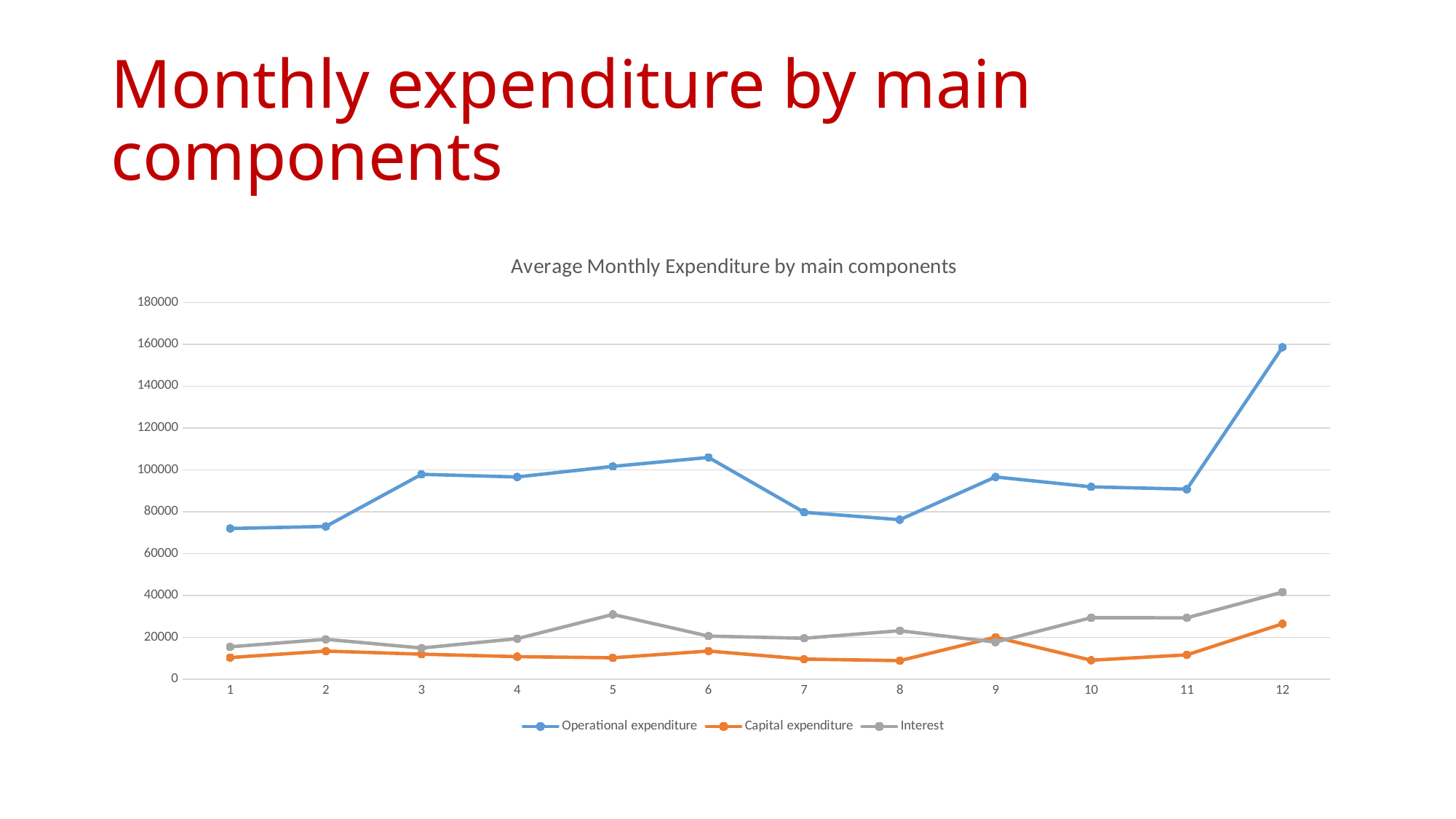
Is the value for Interest in month 5 greater or less than 20000? greater In which month is Operational expenditure highest? 12 In month 12, which is larger: Interest or Capital expenditure? Interest Is the value for Operational expenditure in month 12 greater or less than 140000? greater In which month is Interest highest? 12 Is the value for Operational expenditure in month 8 greater or less than 80000? less How many months are plotted along the x axis? 12 In which month is Capital expenditure highest? 12 How many series does the legend list? 3 Which is larger for Operational expenditure: month 3 or month 7? month 3 What is the title of the chart? Average Monthly Expenditure by main components What kind of chart is shown on the slide? line chart